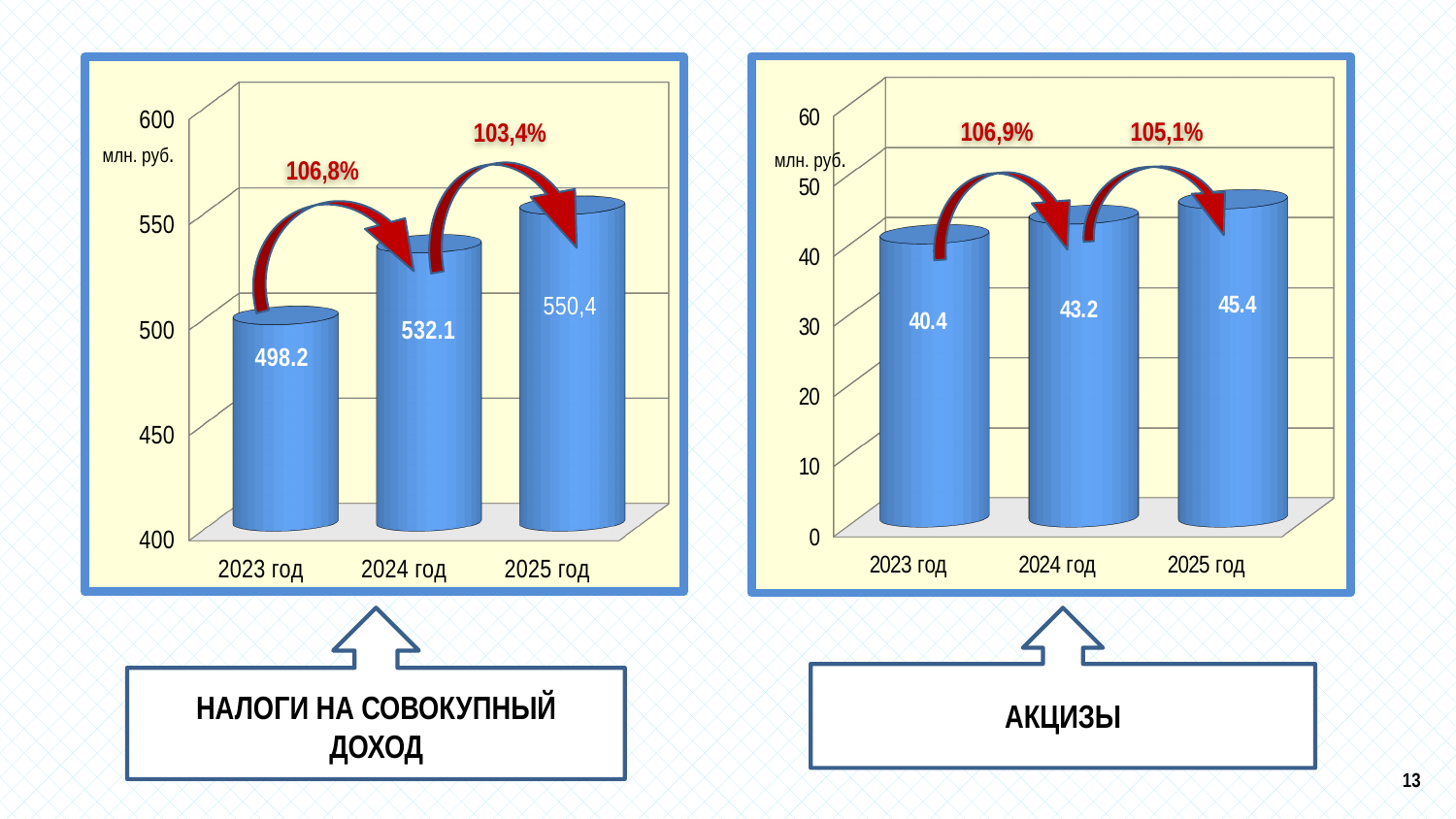
In the chart labelled АКЦИЗЫ (right), which year has the highest value? 2025 год In the chart labelled НАЛОГИ НА СОВОКУПНЫЙ ДОХОД (left), which year has the lowest value? 2023 год What type of chart is the one labelled НАЛОГИ НА СОВОКУПНЫЙ ДОХОД (left)? bar chart How many bars are shown in the chart labelled АКЦИЗЫ (right)? 3 In the chart labelled АКЦИЗЫ (right), what is the value for 2024 год? 43.2 In the chart labelled НАЛОГИ НА СОВОКУПНЫЙ ДОХОД (left), what is the value for 2023 год? 498.2 In the chart labelled АКЦИЗЫ (right), what is the difference between the 2025 год and 2023 год values? 5.0 In the chart labelled НАЛОГИ НА СОВОКУПНЫЙ ДОХОД (left), what is the value for 2025 год? 550,4 In the chart labelled АКЦИЗЫ (right), which is larger, the value for 2023 год or 2024 год? 2024 год In the chart labelled НАЛОГИ НА СОВОКУПНЫЙ ДОХОД (left), what is the difference between the 2024 год and 2023 год values? 33.9 In the chart labelled НАЛОГИ НА СОВОКУПНЫЙ ДОХОД (left), is the value for 2023 год greater or less than 500? less In the chart labelled АКЦИЗЫ (right), do the values rise or fall from 2023 год to 2025 год? rise